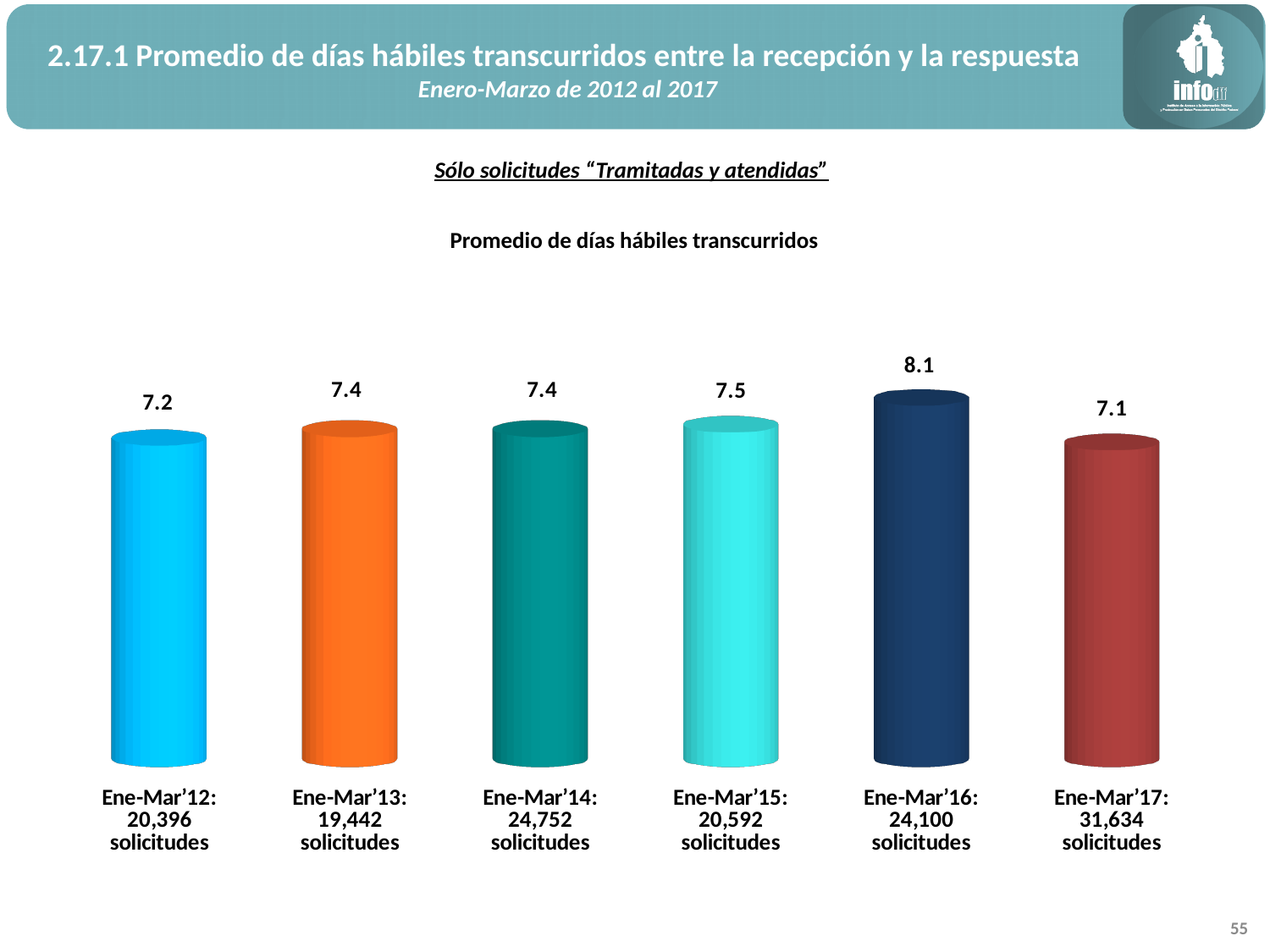
What is the average number of business days for Ene-Mar'16? 8.1 What is the title of the chart? Promedio de días hábiles transcurridos Which period has the lowest average number of business days? Ene-Mar'17 How many solicitudes are listed for Ene-Mar'17? 31,634 How many periods are shown in the chart? 6 What is the difference between the average for Ene-Mar'16 and Ene-Mar'17? 1.0 What kind of chart is shown on the slide? Bar chart What is the average number of business days for Ene-Mar'12? 7.2 What is the difference between the average for Ene-Mar'13 and Ene-Mar'12? 0.2 What is the average number of business days for Ene-Mar'17? 7.1 Which period has the highest average number of business days? Ene-Mar'16 Which is larger, the average for Ene-Mar'15 or Ene-Mar'12? Ene-Mar'15